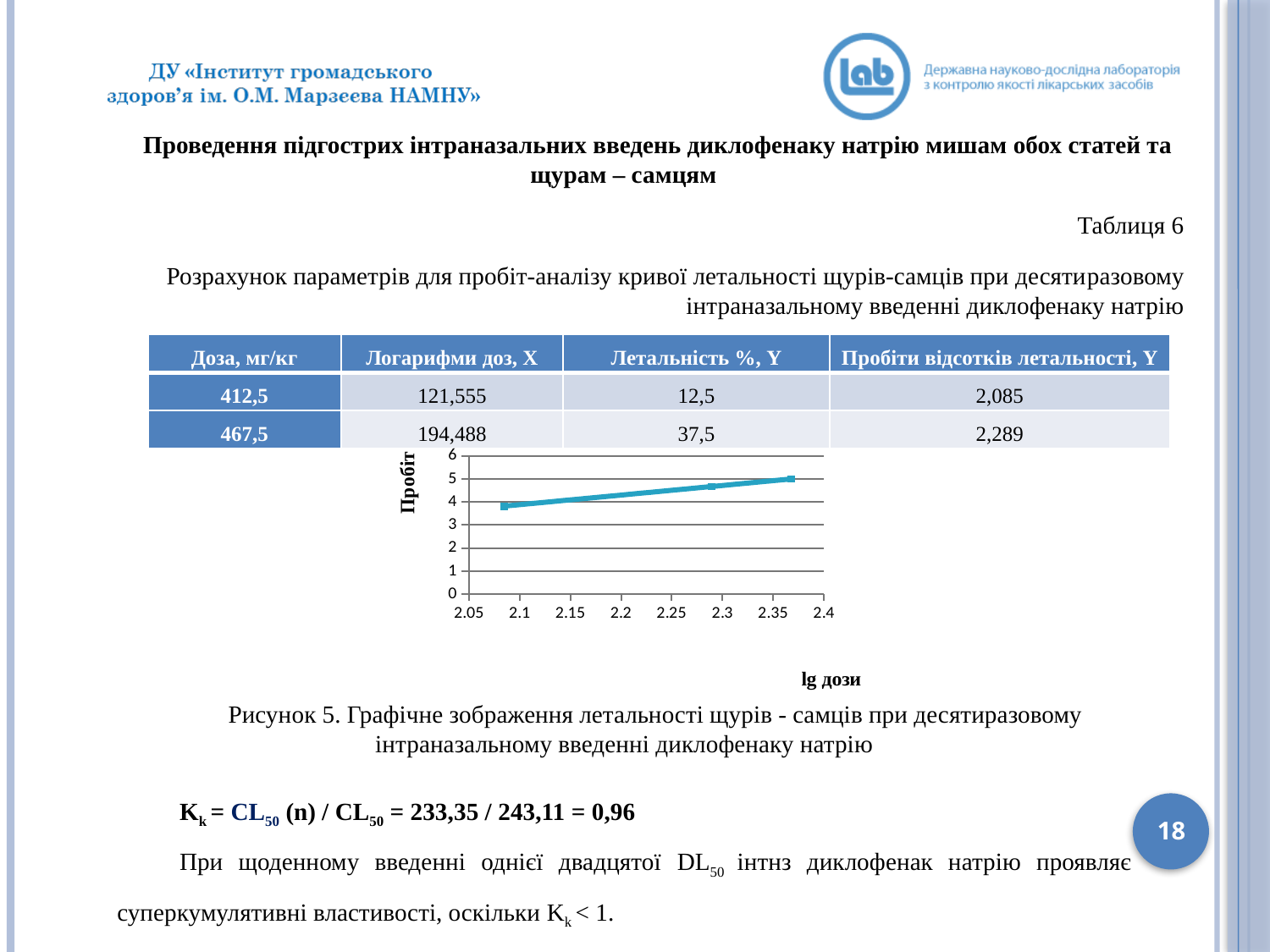
What is the label of the horizontal axis of the chart? lg дози What kind of chart is shown on the slide? line chart How many data points are plotted on the line? 3 What is the label of the vertical axis of the chart? Пробіт Is the value of the rightmost point on the line greater or less than 6? less Which point has the higher value: the leftmost point or the rightmost point on the line? the rightmost point Is the value of the rightmost point on the line greater or less than 4? greater What is the highest tick value shown on the horizontal axis? 2.4 Is the value of the leftmost point on the line greater or less than 3? greater What is the highest tick value shown on the vertical axis? 6 Do the plotted values rise or fall as lg дози increases along the x axis? rise